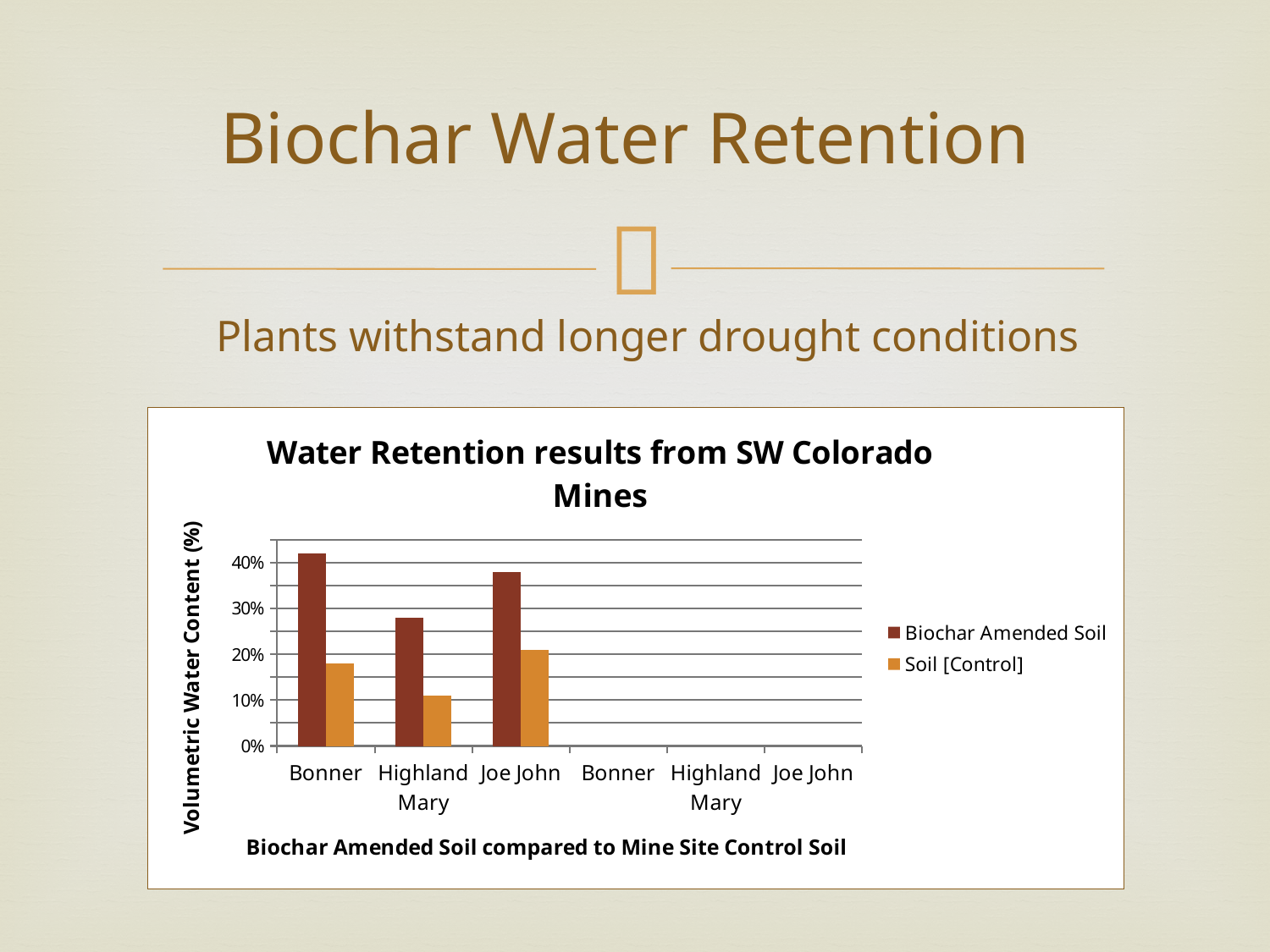
Which site has the lowest Biochar Amended Soil value? Highland Mary What is the title of the chart? Water Retention results from SW Colorado Mines At Bonner, which is larger: the Biochar Amended Soil value or the Soil [Control] value? Biochar Amended Soil Is the Biochar Amended Soil value for Bonner greater or less than 30%? greater Which site has the lowest Soil [Control] value? Highland Mary Which site has the highest Biochar Amended Soil value? Bonner Which is larger: the Soil [Control] value for Joe John or the Soil [Control] value for Highland Mary? Joe John What is the y-axis label of the chart? Volumetric Water Content (%) What kind of chart is shown on the slide? bar chart Is the Soil [Control] value for Highland Mary greater or less than 20%? less Is the Biochar Amended Soil value for Joe John greater or less than 30%? greater How many series does the legend list? 2